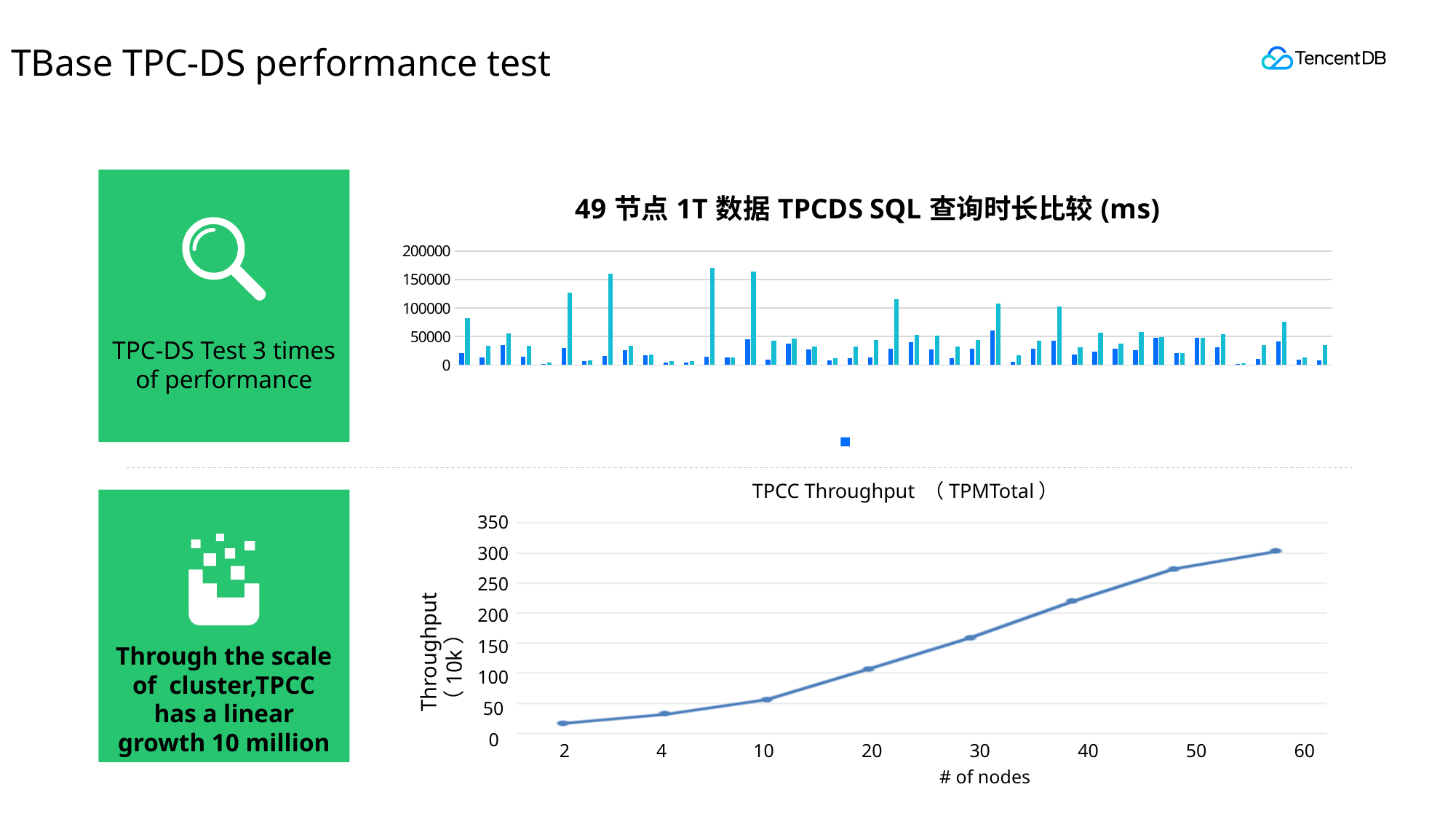
What kind of chart is the bottom chart titled "TPCC Throughput (TPMTotal)"? line chart What is the highest tick value shown on the y axis of the top bar chart? 200000 In the bottom TPCC Throughput chart, is the throughput at 60 nodes greater or less than 250? greater In the bottom TPCC Throughput chart, which has the higher throughput, 2 nodes or 60 nodes? 60 nodes What kind of chart is the top chart titled "49 节点 1T 数据 TPCDS SQL 查询时长比较 (ms)"? bar chart In the top bar chart, is any bar greater or less than 200000? less In the bottom TPCC Throughput chart, do the values rise or fall as the number of nodes increases? rise In the bottom TPCC Throughput chart, is the throughput at 50 nodes greater or less than 250? greater What is the label of the x axis in the bottom TPCC Throughput chart? # of nodes In the bottom TPCC Throughput chart, how many data points are plotted on the line? 8